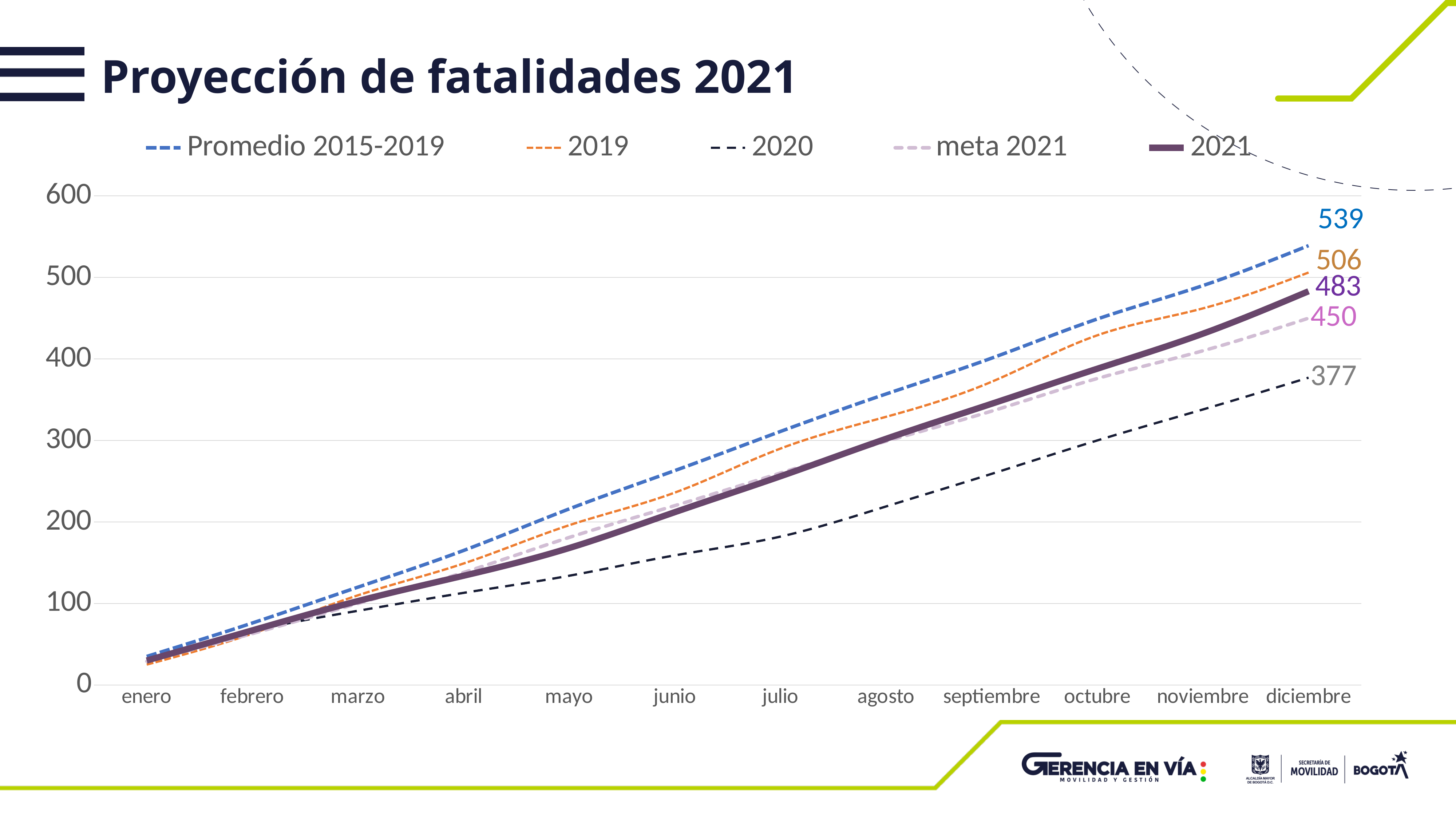
What is the value for meta 2021 in diciembre? 450 What is the value for 2021 in diciembre? 483 How many series does the legend list? 5 What is the value for 2020 in diciembre? 377 Which series has the lowest value in diciembre? 2020 Is the value for 2020 in junio greater or less than 200? less What is the value for 2019 in diciembre? 506 How many months are shown on the x axis? 12 What is the value for Promedio 2015-2019 in diciembre? 539 In diciembre, which is larger: the 2019 value or the 2021 value? 2019 Which series has the highest value in diciembre? Promedio 2015-2019 What is the difference between the 2021 value and the meta 2021 value in diciembre? 33